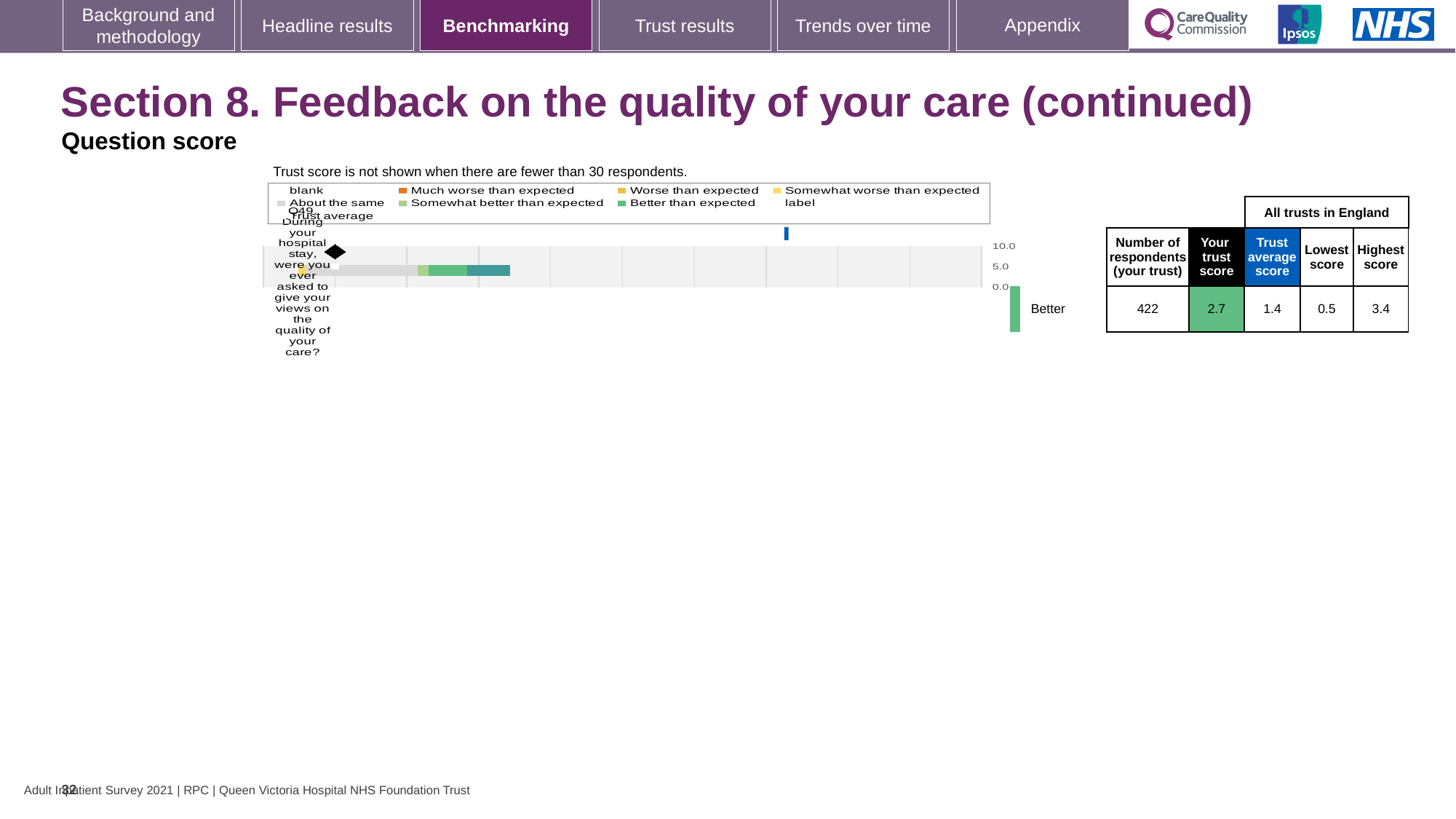
What is the lowest score for Q49 across all trusts in England? 0.5 Which legend entry is shown with an orange marker? Much worse than expected What is your trust score for Q49? 2.7 What kind of chart is used to show the Q49 benchmarking result? bar chart How many survey questions are plotted in the benchmarking chart? 1 Which question number is plotted in the benchmarking chart? Q49 What is the trust average score for Q49 across all trusts in England? 1.4 What is the difference between your trust score and the trust average score for Q49? 1.3 What is the difference between the highest and lowest scores for Q49 across all trusts in England? 2.9 What is the number of respondents for your trust for Q49? 422 What is the highest score for Q49 across all trusts in England? 3.4 Which is larger for Q49: your trust score or the trust average score? Your trust score